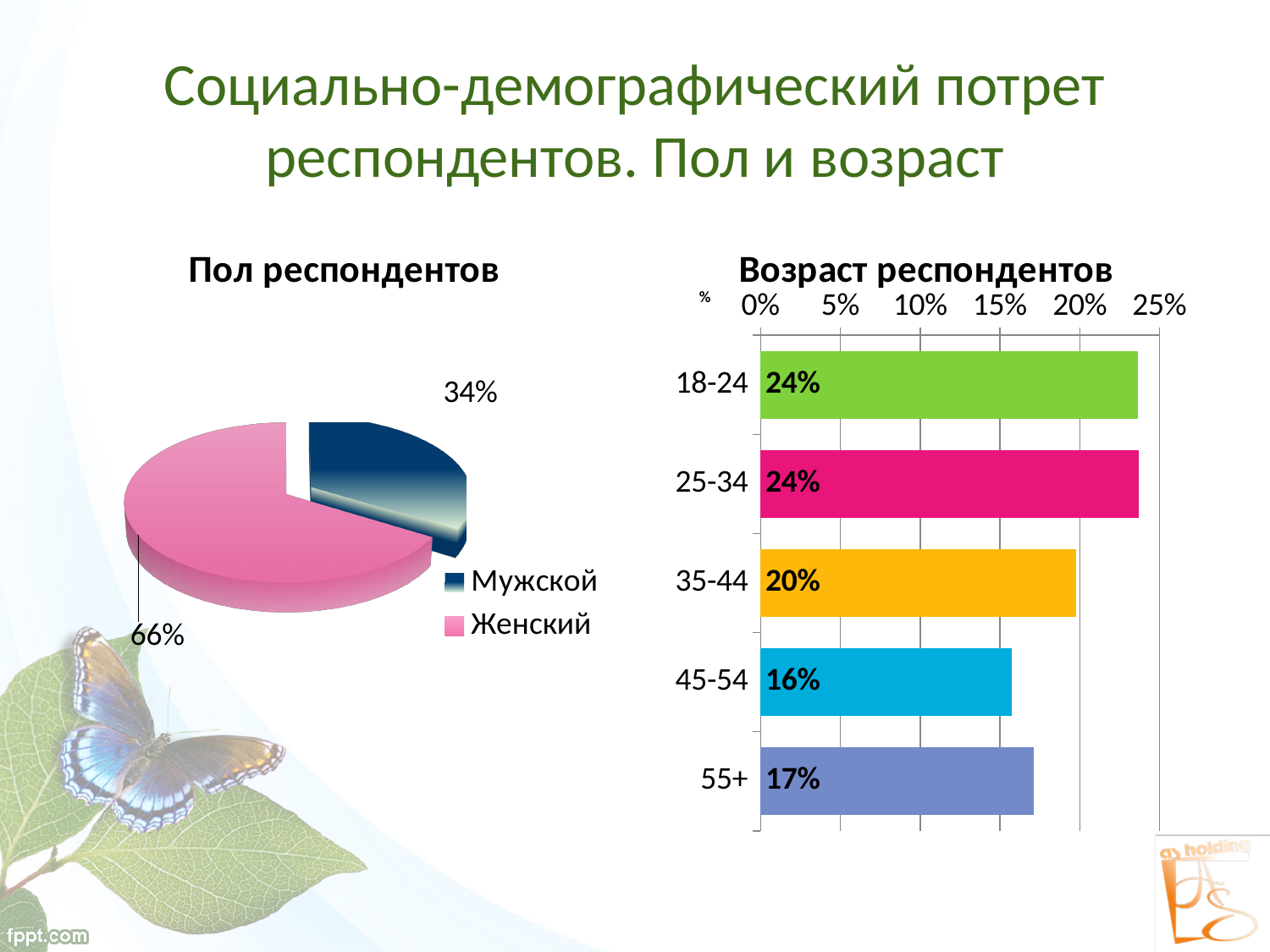
How many age groups are shown in the "Возраст респондентов" chart? 5 In the "Пол респондентов" chart, what share of respondents is Женский? 66% In the "Возраст респондентов" chart, what is the value for 55+? 17% In the "Возраст респондентов" chart, what is the value for 35-44? 20% In the "Пол респондентов" chart, which category has the larger share, Мужской or Женский? Женский In the "Возраст респондентов" chart, what is the difference between the values for 18-24 and 45-54? 8% In the "Возраст респондентов" chart, which age group has the lowest value? 45-54 What kind of chart is "Возраст респондентов"? Bar chart In the "Пол респондентов" chart, what share of respondents is Мужской? 34% In the "Возраст респондентов" chart, which is larger, the value for 35-44 or the value for 55+? 35-44 How many entries does the legend of the "Пол респондентов" chart list? 2 What kind of chart is "Пол респондентов"? Pie chart